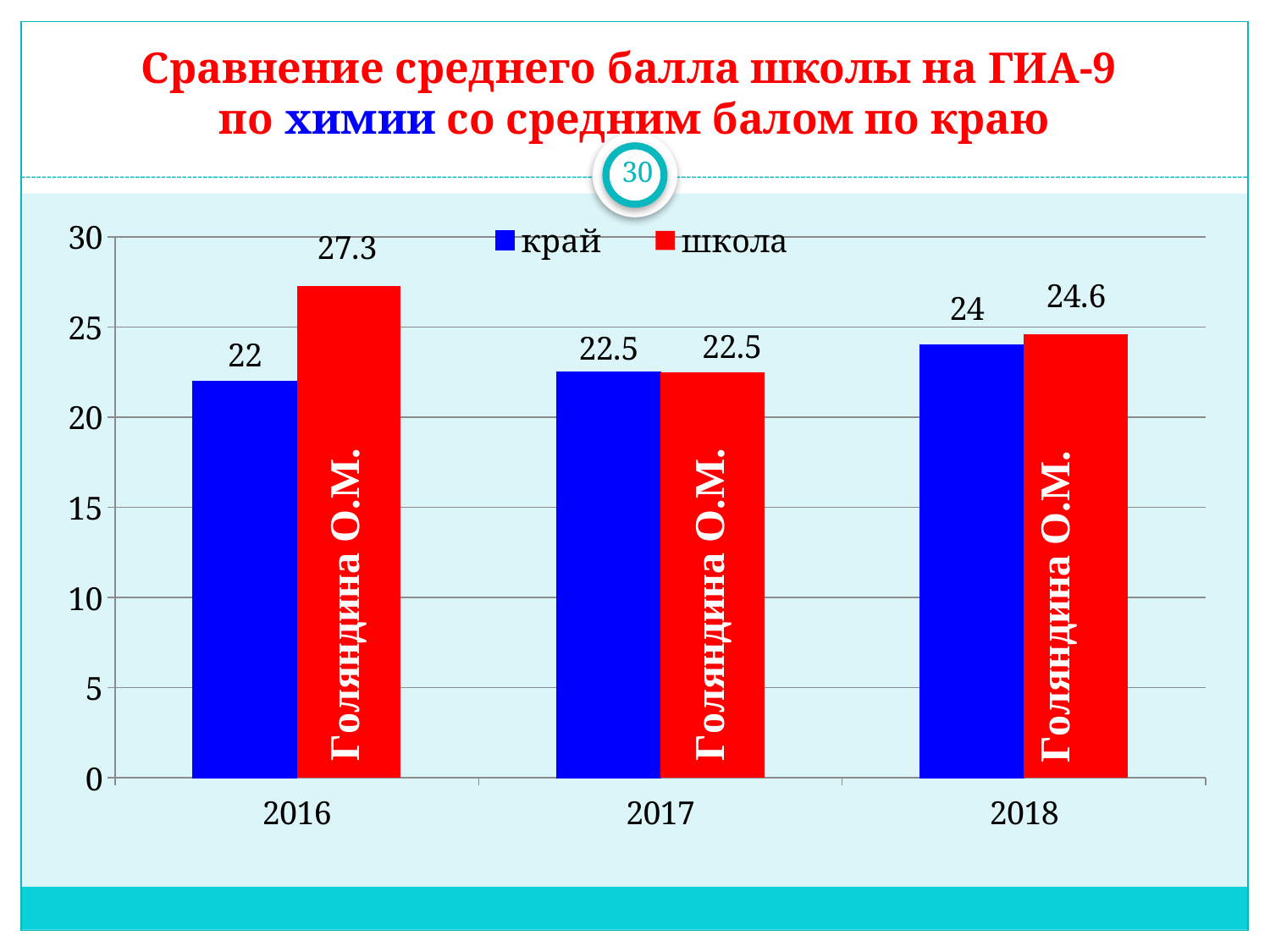
In which year is the край value lowest? 2016 What is the difference between the школа and край values in 2016? 5.3 What is the value for край in 2016? 22 What kind of chart is shown on the slide? bar chart How many years are shown on the x axis? 3 How many series does the legend list? 2 What is the value for школа in 2018? 24.6 What is the value for край in 2018? 24 What is the value for школа in 2016? 27.3 In which year is the школа value highest? 2016 Which is larger in 2018, край or школа? школа Is the value for школа in 2016 greater or less than 25? greater